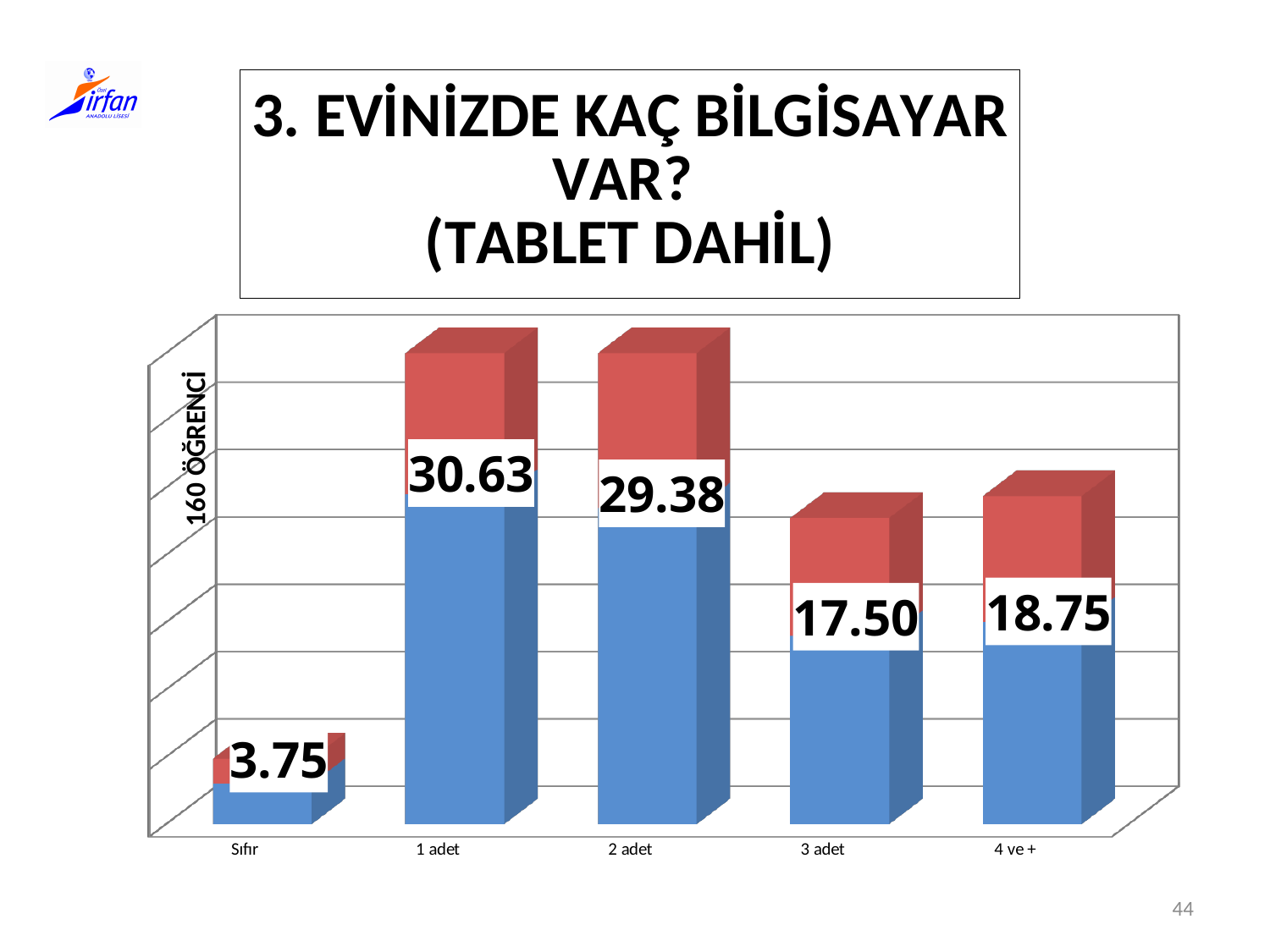
How many categories are shown on the x axis? 5 What value is labelled on the bar for "1 adet"? 30.63 What kind of chart is shown on the slide? Bar chart What value is labelled on the bar for "4 ve +"? 18.75 Which has the larger labelled value, "3 adet" or "4 ve +"? 4 ve + What is the difference between the labelled values for "1 adet" and "2 adet"? 1.25 What value is labelled on the bar for "3 adet"? 17.50 What value is labelled on the bar for "2 adet"? 29.38 What is the difference between the labelled values for "4 ve +" and "3 adet"? 1.25 Which category has the lowest labelled value? Sıfır Which category has the highest labelled value? 1 adet What value is labelled on the bar for "Sıfır"? 3.75